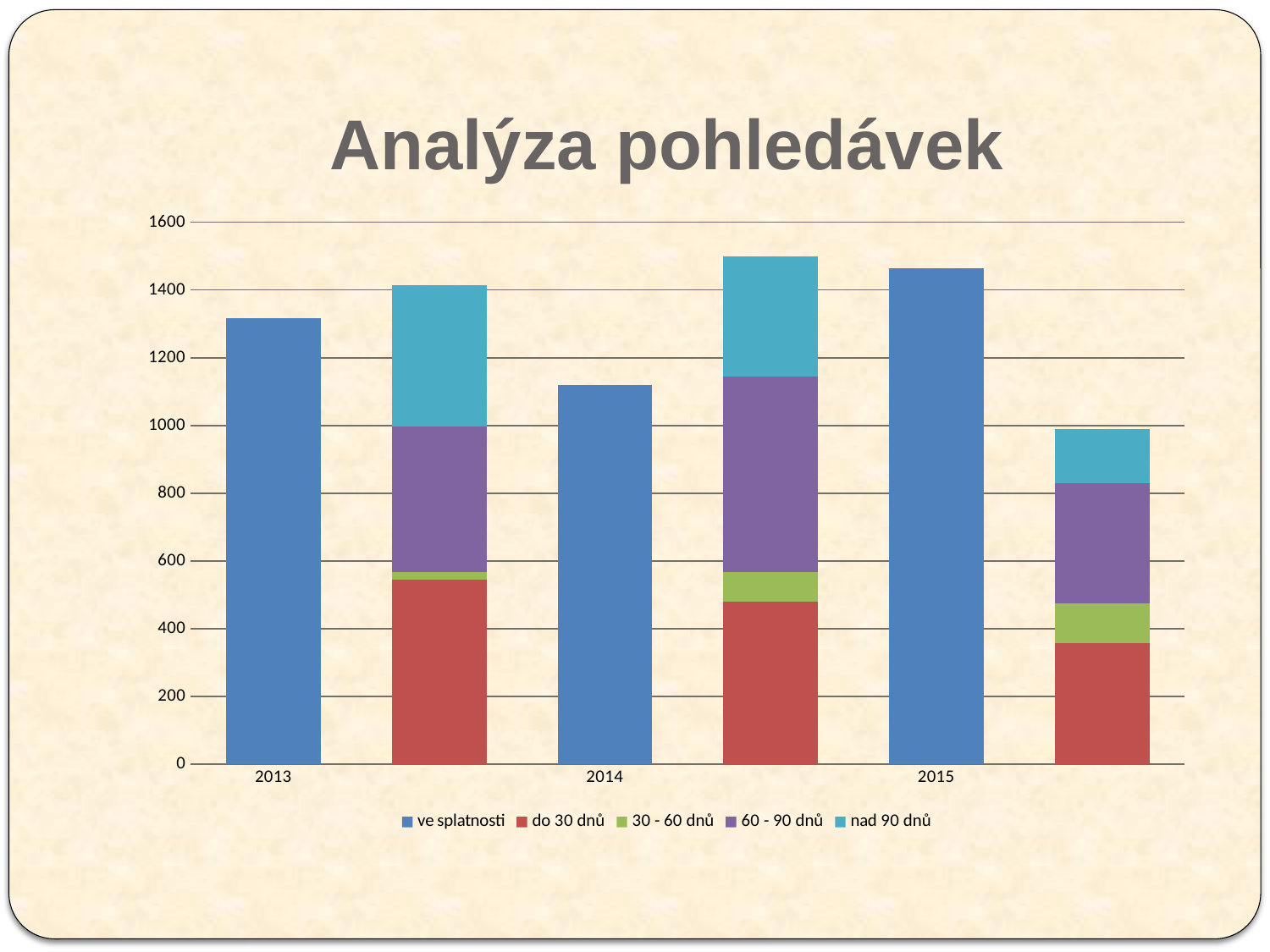
What kind of chart is shown on the slide? stacked bar chart Is the total of the stacked overdue bar for 2014 greater or less than 1400? greater How many series does the legend list? 5 What is the title of the chart? Analýza pohledávek Which legend entry is shown in red? do 30 dnů Is the total of the stacked overdue bar for 2015 greater or less than 1200? less Which year has the lowest value for 've splatnosti'? 2014 Is the value for 've splatnosti' in 2014 greater or less than 1200? less How many years are shown on the x axis? 3 Which year has the highest value for 've splatnosti'? 2015 Which is larger, the 've splatnosti' value for 2013 or for 2014? 2013